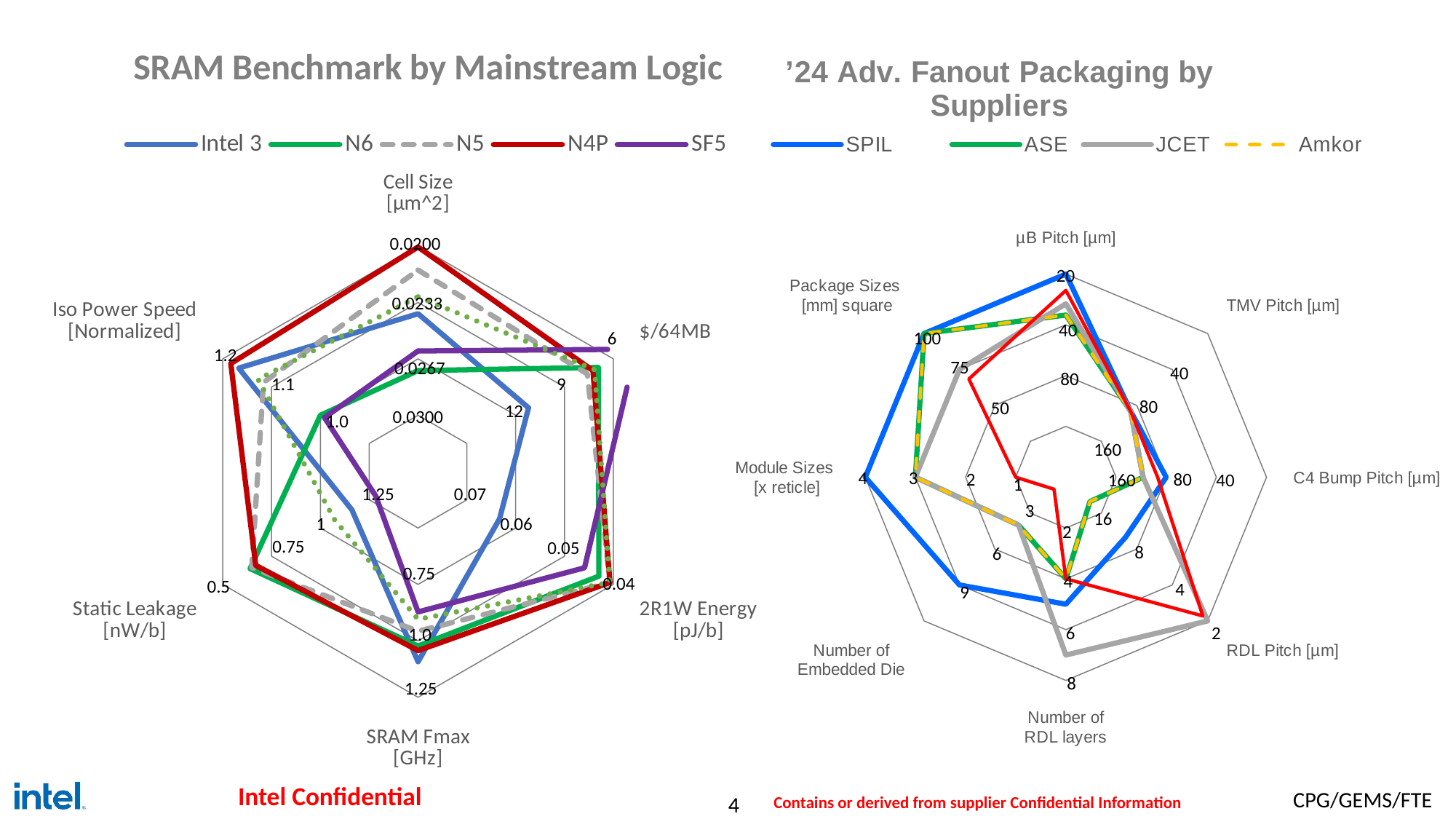
On the 'SRAM Benchmark by Mainstream Logic' chart, how many series does the legend list? 5 What kind of chart is the ''24 Adv. Fanout Packaging by Suppliers' chart? radar chart On the 'SRAM Benchmark by Mainstream Logic' chart, how many axes (categories) are plotted? 6 On the ''24 Adv. Fanout Packaging by Suppliers' chart, how many series does the legend list? 4 What kind of chart is the 'SRAM Benchmark by Mainstream Logic' chart? radar chart On the ''24 Adv. Fanout Packaging by Suppliers' chart, is the value for SPIL on the Module Sizes axis greater or less than 3? greater On the ''24 Adv. Fanout Packaging by Suppliers' chart, which series is drawn with a dashed yellow line? Amkor On the ''24 Adv. Fanout Packaging by Suppliers' chart, is the value for SPIL on the Package Sizes axis greater or less than 75? greater On the ''24 Adv. Fanout Packaging by Suppliers' chart, is the value for JCET on the Number of RDL layers axis greater or less than 6? greater On the 'SRAM Benchmark by Mainstream Logic' chart, which series is drawn with a dashed grey line? N5 On the ''24 Adv. Fanout Packaging by Suppliers' chart, how many axes (categories) are plotted? 8